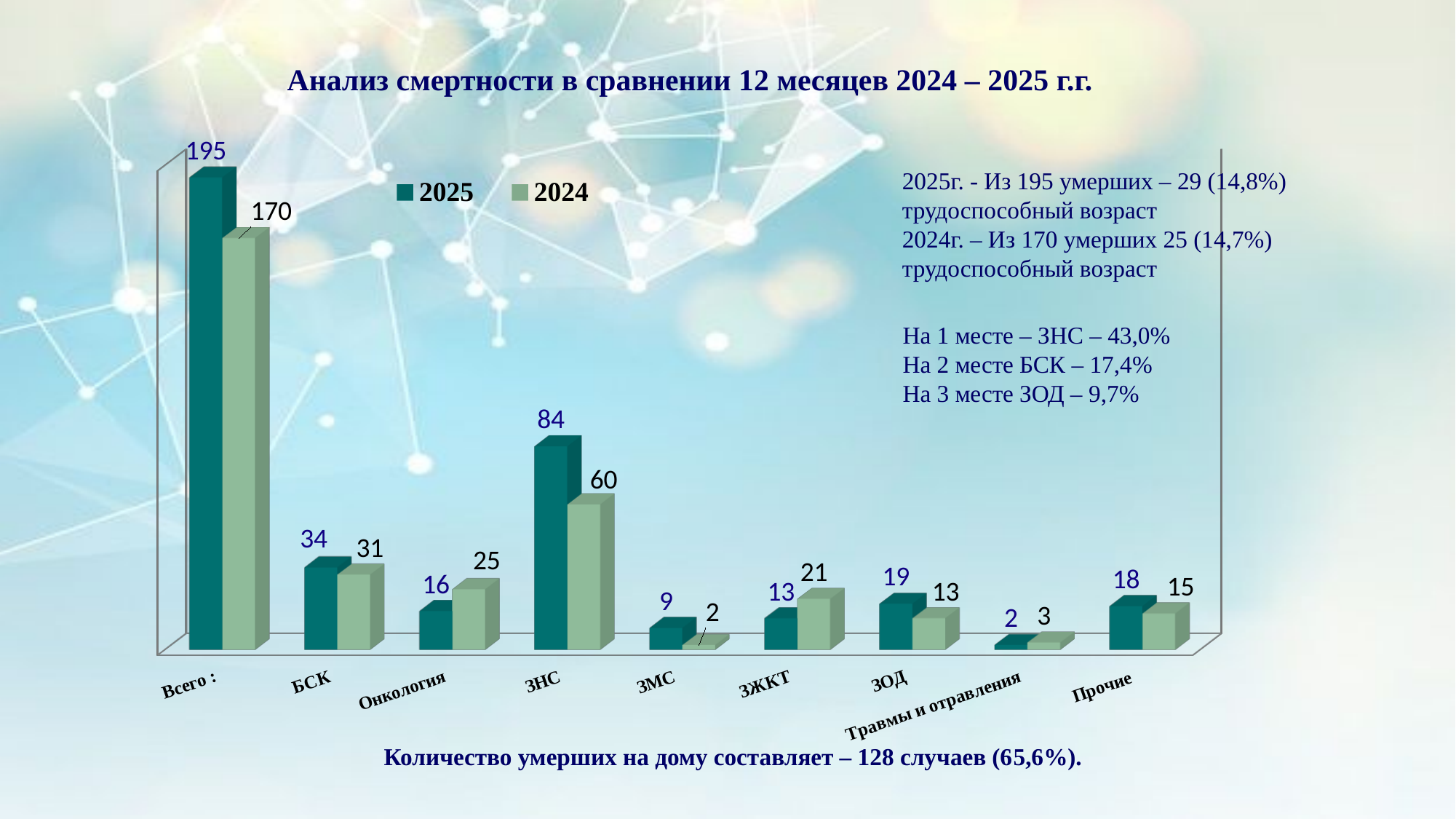
For ЗОД, which series has the larger value, 2025 or 2024? 2025 Which category has the lowest value in the 2025 series? Травмы и отравления What is the value for Онкология in the 2024 series? 25 For ЗЖКТ, which series has the larger value, 2025 or 2024? 2024 How many series does the legend list? 2 What is the difference between the 2025 and 2024 values for Всего? 25 How many categories are shown on the x axis? 9 What is the difference between the 2025 and 2024 values for ЗНС? 24 What kind of chart is shown on the slide? Bar chart What is the value for ЗНС in the 2025 series? 84 What is the value for ЗМС in the 2025 series? 9 Excluding the Всего total, which category has the highest value in the 2024 series? ЗНС